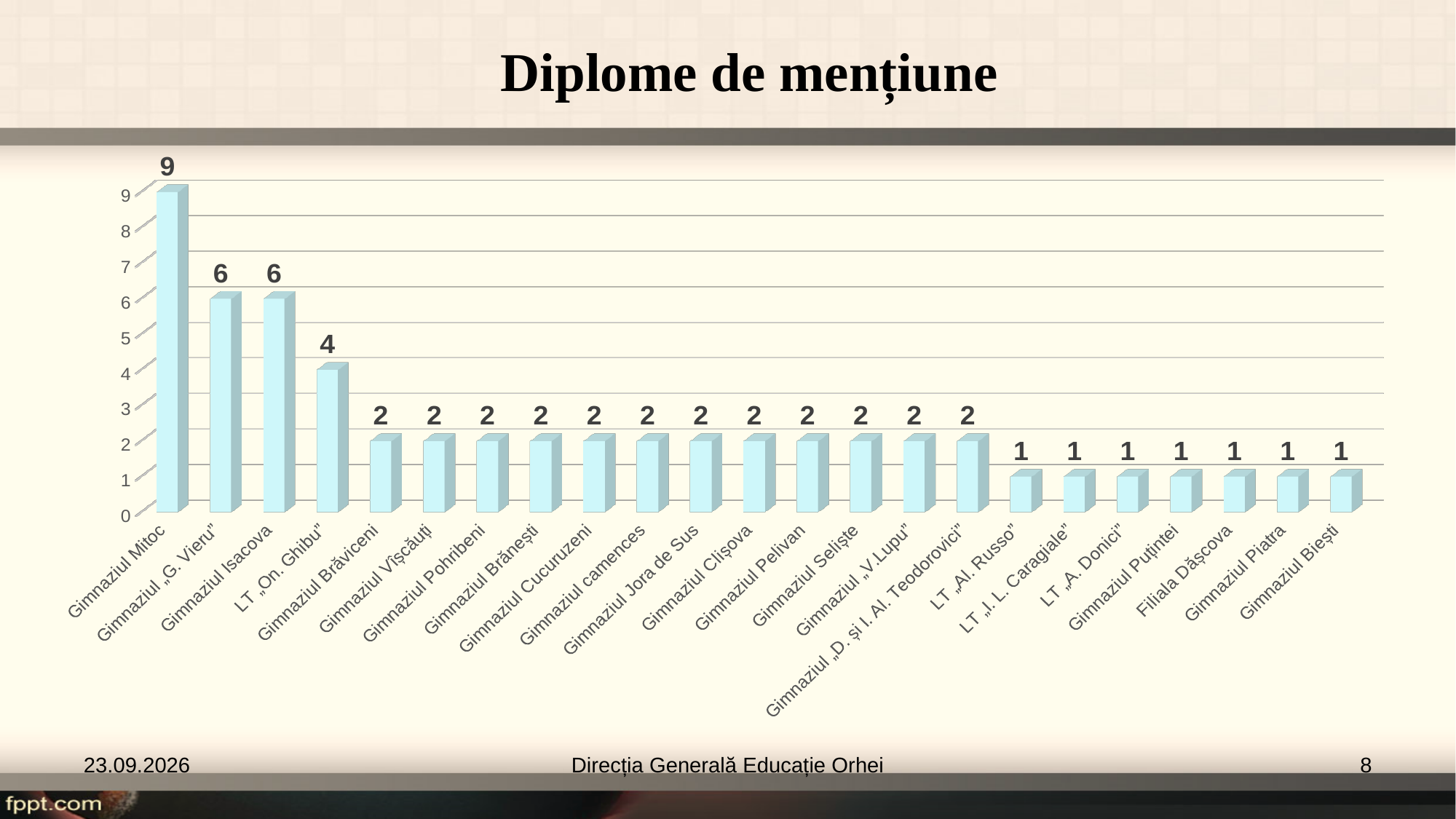
What kind of chart is shown on the slide? Bar chart Which is larger, the value for Gimnaziul Isacova or the value for LT „On. Ghibu”? Gimnaziul Isacova What is the difference between the values for Gimnaziul Mitoc and Gimnaziul „G. Vieru”? 3 Which category has the highest value? Gimnaziul Mitoc How many categories are shown on the x axis? 23 What is the value for Gimnaziul Mitoc? 9 What is the value for LT „On. Ghibu”? 4 What is the title of the chart? Diplome de mențiune What is the value for Gimnaziul Piatra? 1 What is the difference between the values for LT „On. Ghibu” and Gimnaziul Brăviceni? 2 What is the value for Gimnaziul Isacova? 6 How many categories have a value of 1? 7